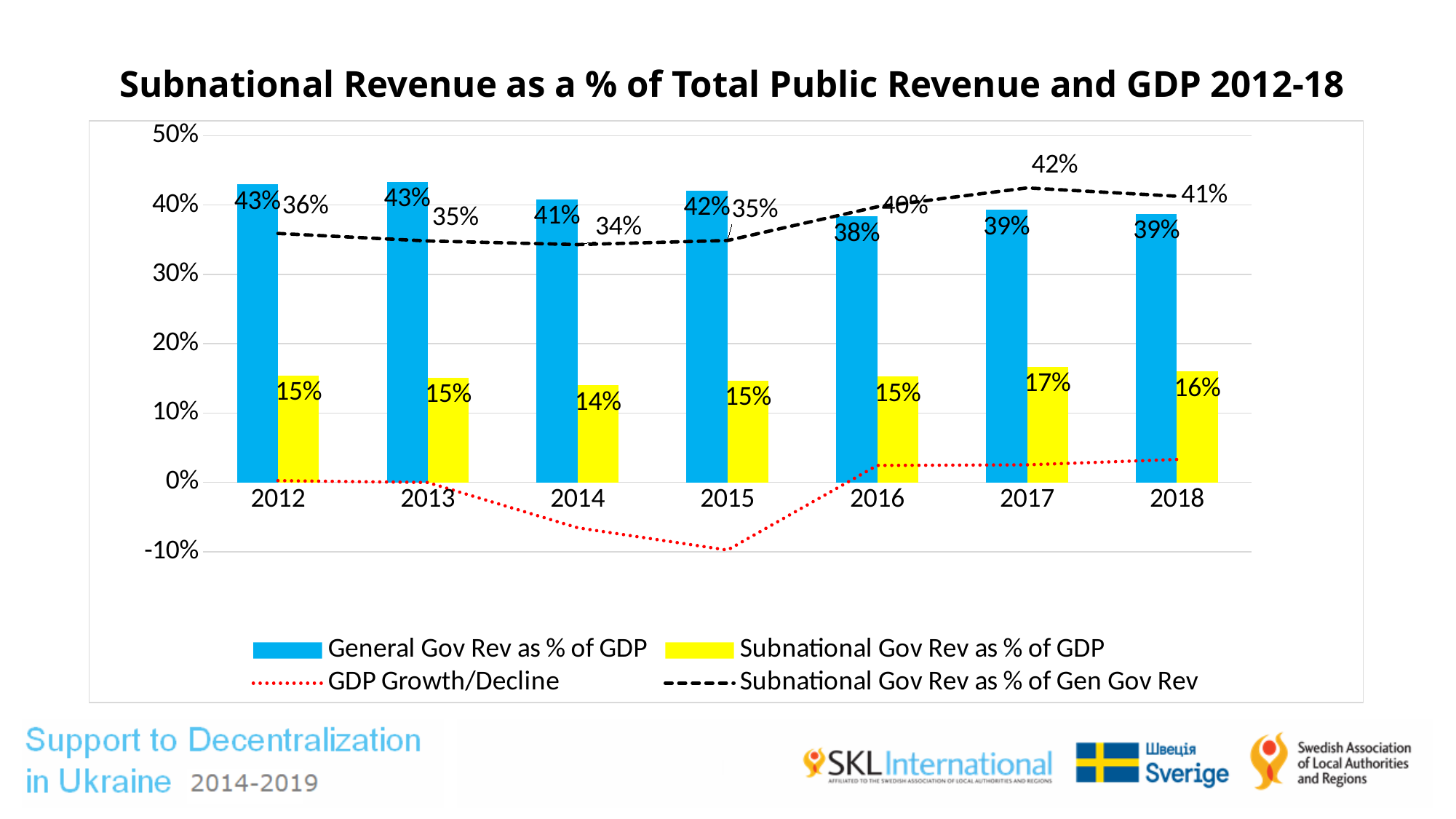
What is the Subnational Gov Rev as % of GDP value for 2017? 17% What is the General Gov Rev as % of GDP value for 2016? 38% How many series does the legend list? 4 What is the Subnational Gov Rev as % of Gen Gov Rev value for 2014? 34% In which year is Subnational Gov Rev as % of GDP lowest? 2014 In which year is General Gov Rev as % of GDP lowest? 2016 Is the GDP Growth/Decline value for 2015 greater or less than 0%? less How many years are shown on the x axis? 7 Which year has the larger Subnational Gov Rev as % of Gen Gov Rev, 2012 or 2017? 2017 What is the difference between General Gov Rev as % of GDP in 2012 and in 2018? 4 percentage points Does Subnational Gov Rev as % of Gen Gov Rev rise or fall from 2015 to 2017? rise In which year is Subnational Gov Rev as % of Gen Gov Rev highest? 2017